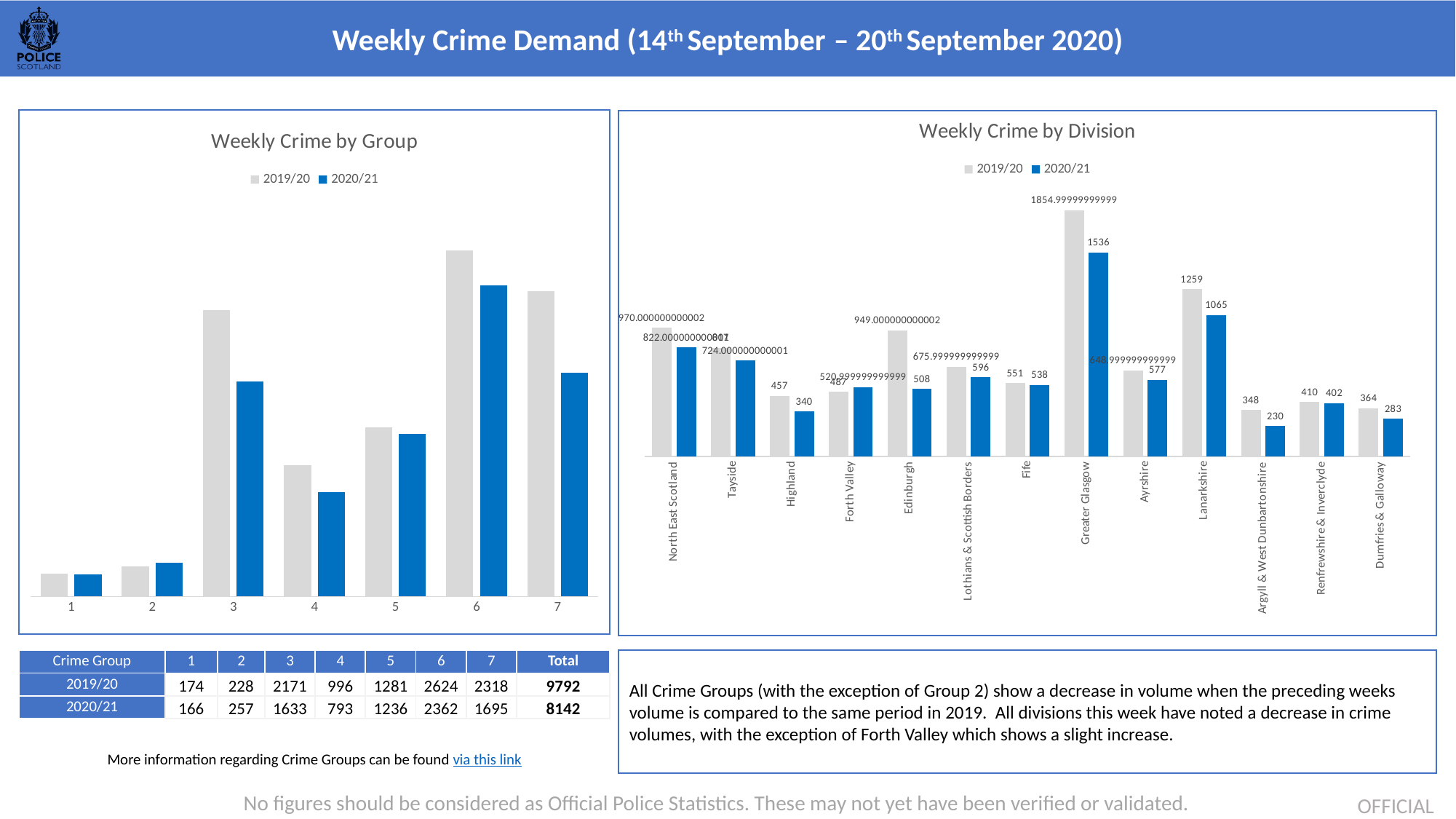
In the 'Weekly Crime by Division' chart, which division has the highest 2020/21 value? Greater Glasgow How many divisions are shown on the x axis of the 'Weekly Crime by Division' chart? 13 How many series does the legend of the 'Weekly Crime by Division' chart list? 2 In the 'Weekly Crime by Division' chart, what is the 2020/21 value for Highland? 340 How many crime groups are shown on the x axis of the 'Weekly Crime by Group' chart? 7 In the 'Weekly Crime by Group' chart, which group has the highest 2020/21 bar? 6 What kind of chart is the 'Weekly Crime by Division' chart? bar chart In the 'Weekly Crime by Division' chart, what is the difference between the 2019/20 and 2020/21 values for Lanarkshire? 194 In the 'Weekly Crime by Division' chart, what is the 2019/20 value for Lanarkshire? 1259 In the 'Weekly Crime by Division' chart, what is the difference between the 2019/20 and 2020/21 values for Argyll & West Dunbartonshire? 118 In the 'Weekly Crime by Division' chart, which series has the larger value for Fife, 2019/20 or 2020/21? 2019/20 In the 'Weekly Crime by Division' chart, which division has the lowest 2020/21 value? Argyll & West Dunbartonshire